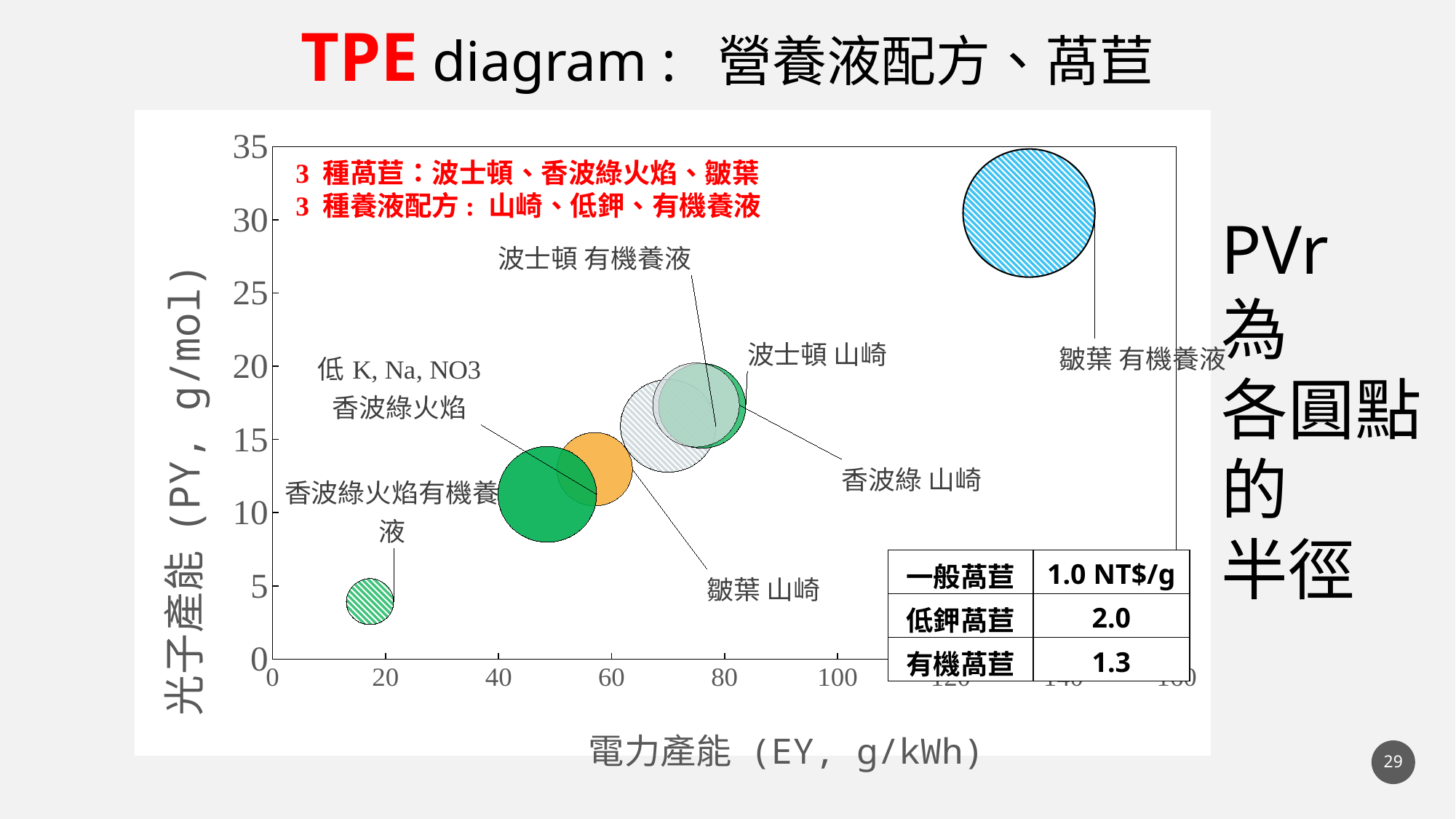
What does the radius of each bubble represent, according to the slide? PVr According to the table on the chart, what is the price for 低鉀萵苣? 2.0 Is the 電力產能 (EY) value for 香波綠火焰有機養液 greater or less than 20? less Is the 電力產能 (EY) value for 皺葉 有機養液 greater or less than 120? greater Which has a higher 光子產能 (PY): 皺葉 有機養液 or 皺葉 山崎? 皺葉 有機養液 Which data point has the highest 電力產能 (EY)? 皺葉 有機養液 Is the 光子產能 (PY) value for 皺葉 有機養液 greater or less than 25? greater Which data point has the highest 光子產能 (PY)? 皺葉 有機養液 What kind of chart is shown on the slide? bubble chart Which data point has the lowest 光子產能 (PY)? 香波綠火焰有機養液 How many bubbles (data points) are plotted in the chart? 7